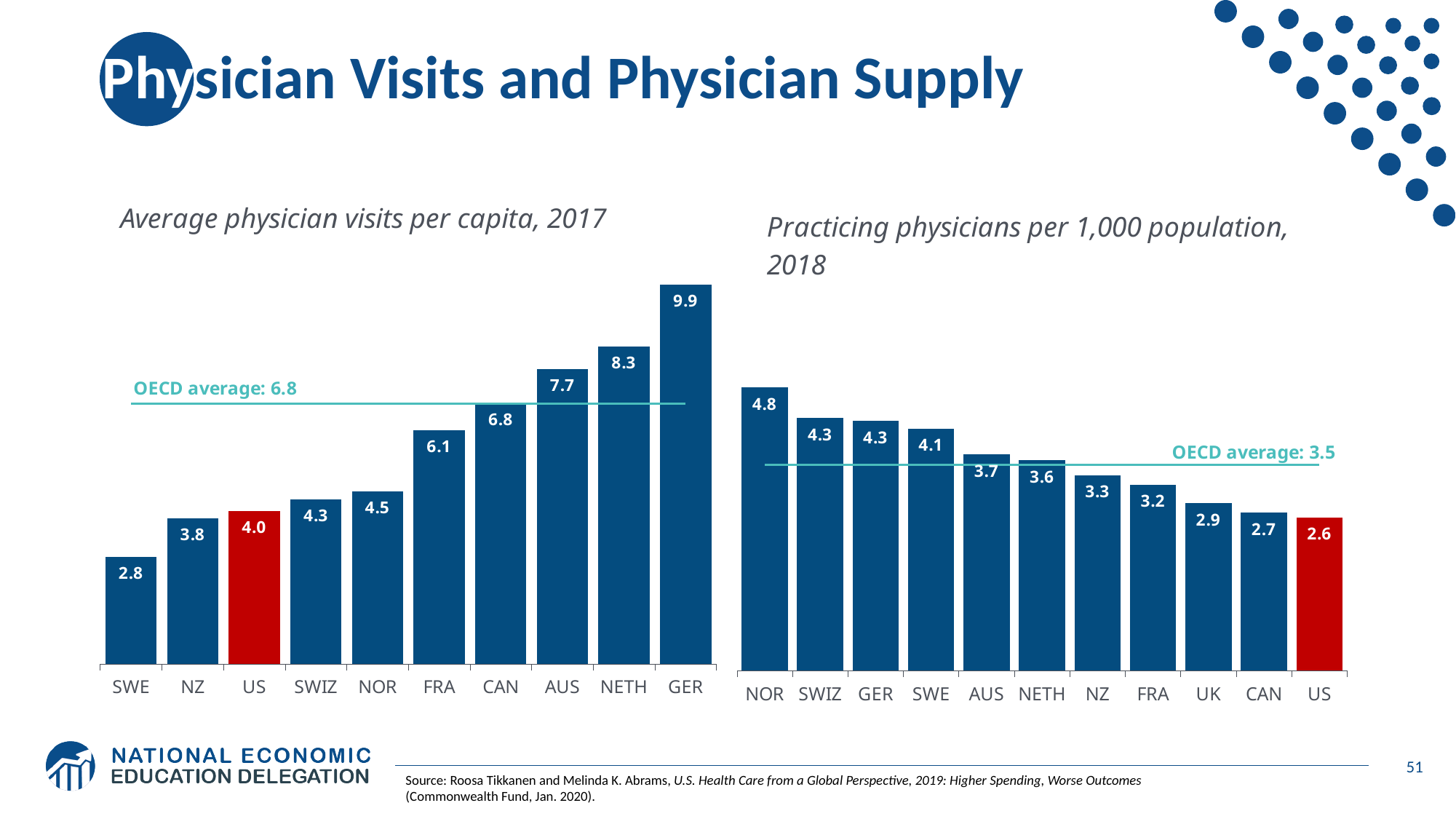
In the 'Average physician visits per capita, 2017' chart, which country has the lowest value? SWE In the 'Average physician visits per capita, 2017' chart, what is the value for the US? 4.0 In the 'Practicing physicians per 1,000 population, 2018' chart, which is larger, the value for UK or the value for CAN? UK In the 'Average physician visits per capita, 2017' chart, what OECD average is shown? 6.8 In the 'Practicing physicians per 1,000 population, 2018' chart, how many countries are shown? 11 In the 'Average physician visits per capita, 2017' chart, which country has the highest value? GER In the 'Practicing physicians per 1,000 population, 2018' chart, what is the difference between NOR and US? 2.2 What type of chart is the 'Practicing physicians per 1,000 population, 2018' chart? Bar chart In the 'Average physician visits per capita, 2017' chart, what is the difference between GER and NETH? 1.6 In the 'Average physician visits per capita, 2017' chart, how many countries are shown? 10 In the 'Practicing physicians per 1,000 population, 2018' chart, what is the value for NOR? 4.8 In the 'Practicing physicians per 1,000 population, 2018' chart, which country has the lowest value? US